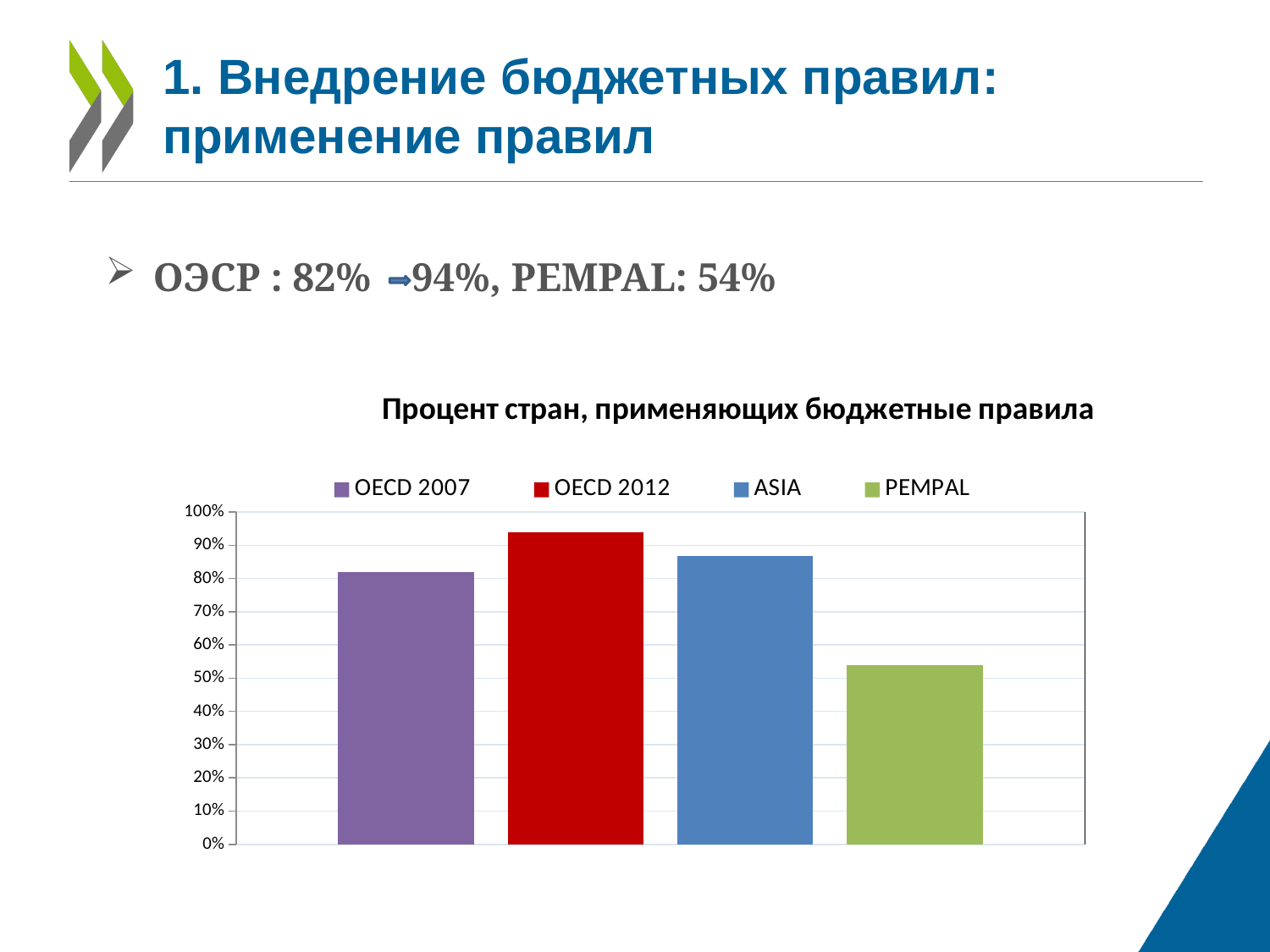
Is the value for OECD 2012 greater or less than 90%? greater Which is larger, the value for ASIA or the value for OECD 2007? ASIA Is the value for PEMPAL greater or less than 60%? less Which is larger, the value for OECD 2012 or the value for ASIA? OECD 2012 Which series has the highest bar in the chart? OECD 2012 What kind of chart is shown on the slide? bar chart How many series does the chart legend list? 4 Which series has the lowest bar in the chart? PEMPAL What is the title of the chart? Процент стран, применяющих бюджетные правила What colour is the OECD 2012 bar in the chart? red Is the value for ASIA greater or less than 80%? greater How many bars are plotted in the chart? 4